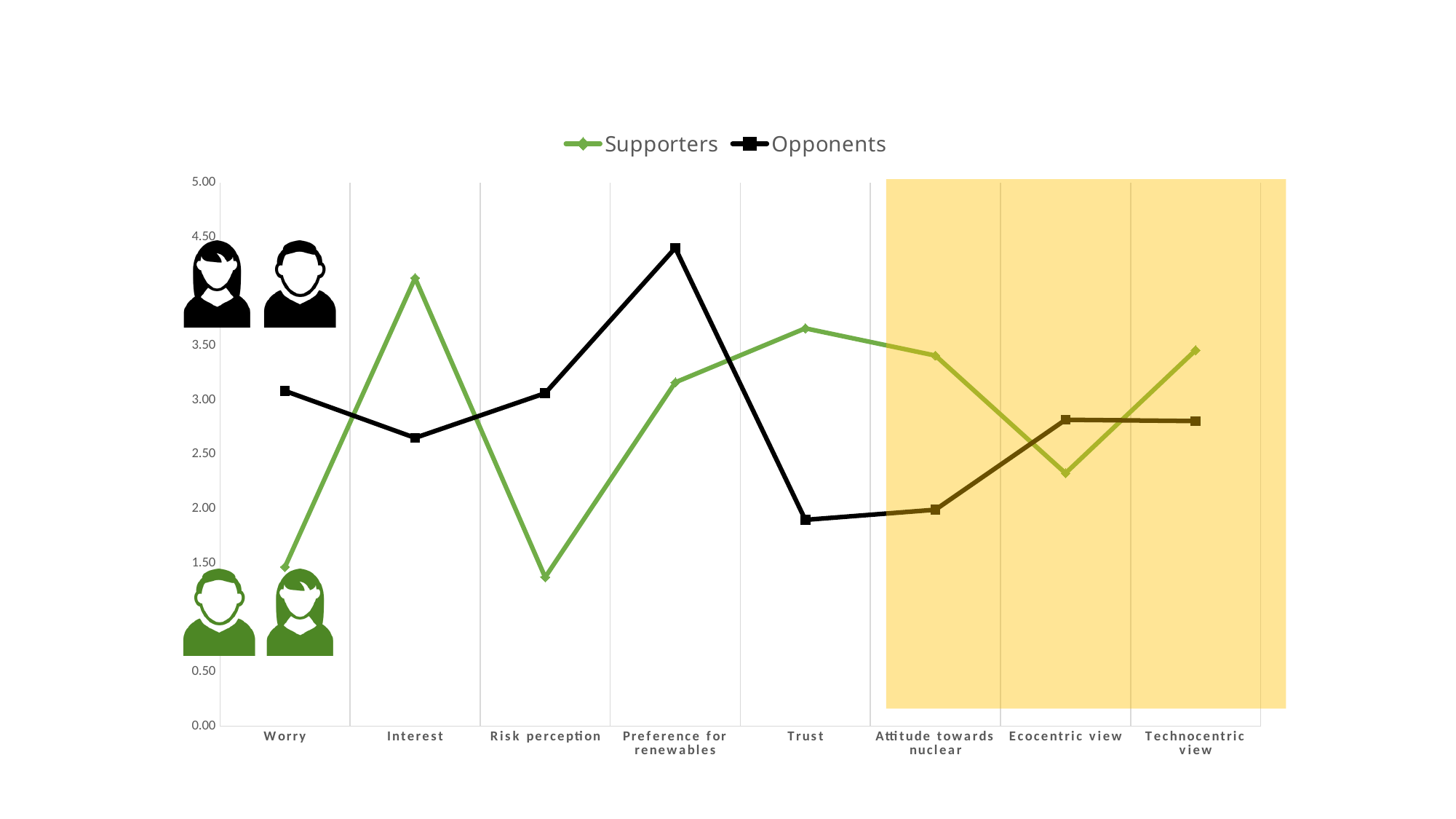
Is the Supporters value for Interest greater or less than 3.50? greater How many categories are shown on the x axis? 8 For Trust, which series has the larger value, Supporters or Opponents? Supporters Is the Supporters value for Ecocentric view greater or less than 2.50? less For Worry, which series has the larger value, Supporters or Opponents? Opponents For which category is the Supporters line lowest? Risk perception Is the Opponents value for Preference for renewables greater or less than 4.00? greater For which category is the Supporters line highest? Interest What colour is the Supporters line? green What kind of chart is shown on the slide? line chart For which category is the Opponents line highest? Preference for renewables How many series does the legend list? 2